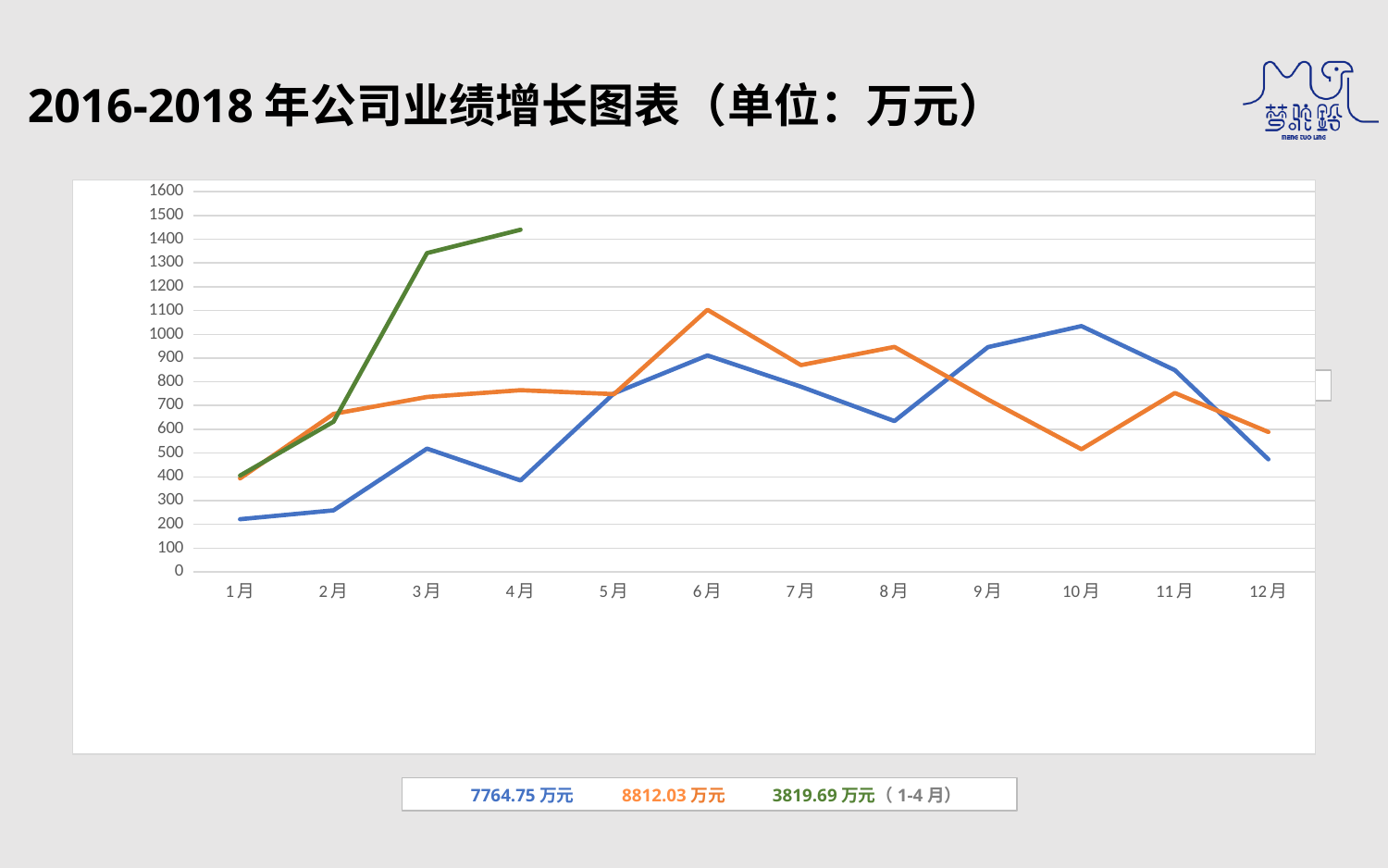
What is the title of the chart on the slide? 2016-2018 年公司业绩增长图表（单位：万元） In which month does the blue line reach its highest value? 10月 Is the value of the blue line in 1月 greater or less than 300? less Does the green line rise or fall from 1月 to 4月? rise In which month does the blue line have its lowest value? 1月 How many lines (series) are plotted on the chart? 3 Is the value of the blue line in 10月 greater or less than 1000? greater What kind of chart is shown on the slide? line chart In 3月, which line has the larger value, the blue line or the orange line? orange How many months are shown along the x axis of the chart? 12 Is the value of the green line in 4月 greater or less than 1300? greater In which month does the orange line reach its highest value? 6月